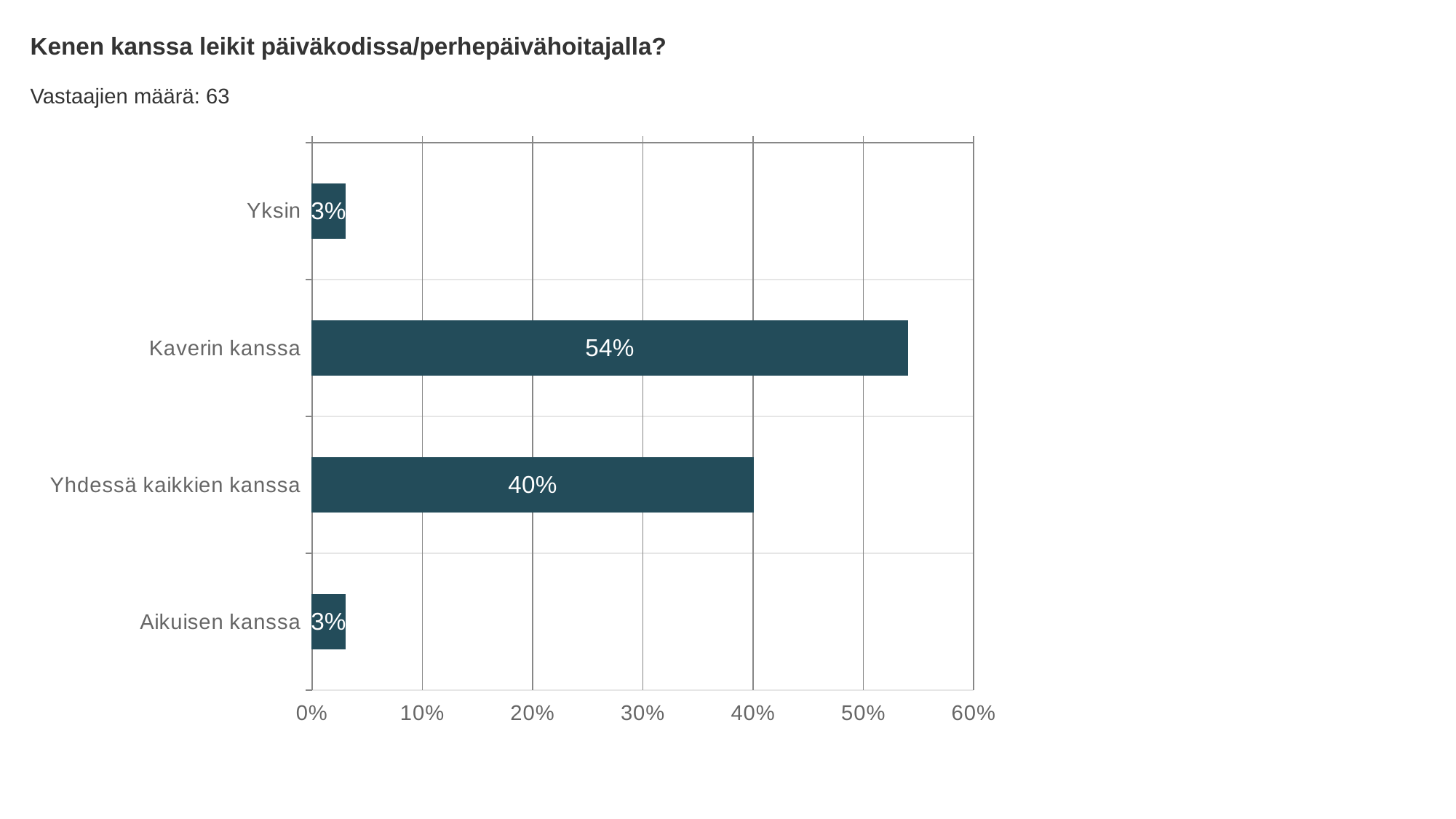
What is the value for Kaverin kanssa? 54% What kind of chart is shown on the slide? bar chart Which category has the highest value? Kaverin kanssa What is the value for Aikuisen kanssa? 3% What is the value for Yhdessä kaikkien kanssa? 40% What is the value for Yksin? 3% Is the value for Kaverin kanssa greater or less than 50%? greater What is the number of respondents (Vastaajien määrä) stated on the slide? 63 Which is larger, the value for Kaverin kanssa or the value for Yhdessä kaikkien kanssa? Kaverin kanssa What is the difference between the values for Kaverin kanssa and Yhdessä kaikkien kanssa? 14% Is the value for Yksin greater or less than 10%? less How many categories are shown in the chart? 4